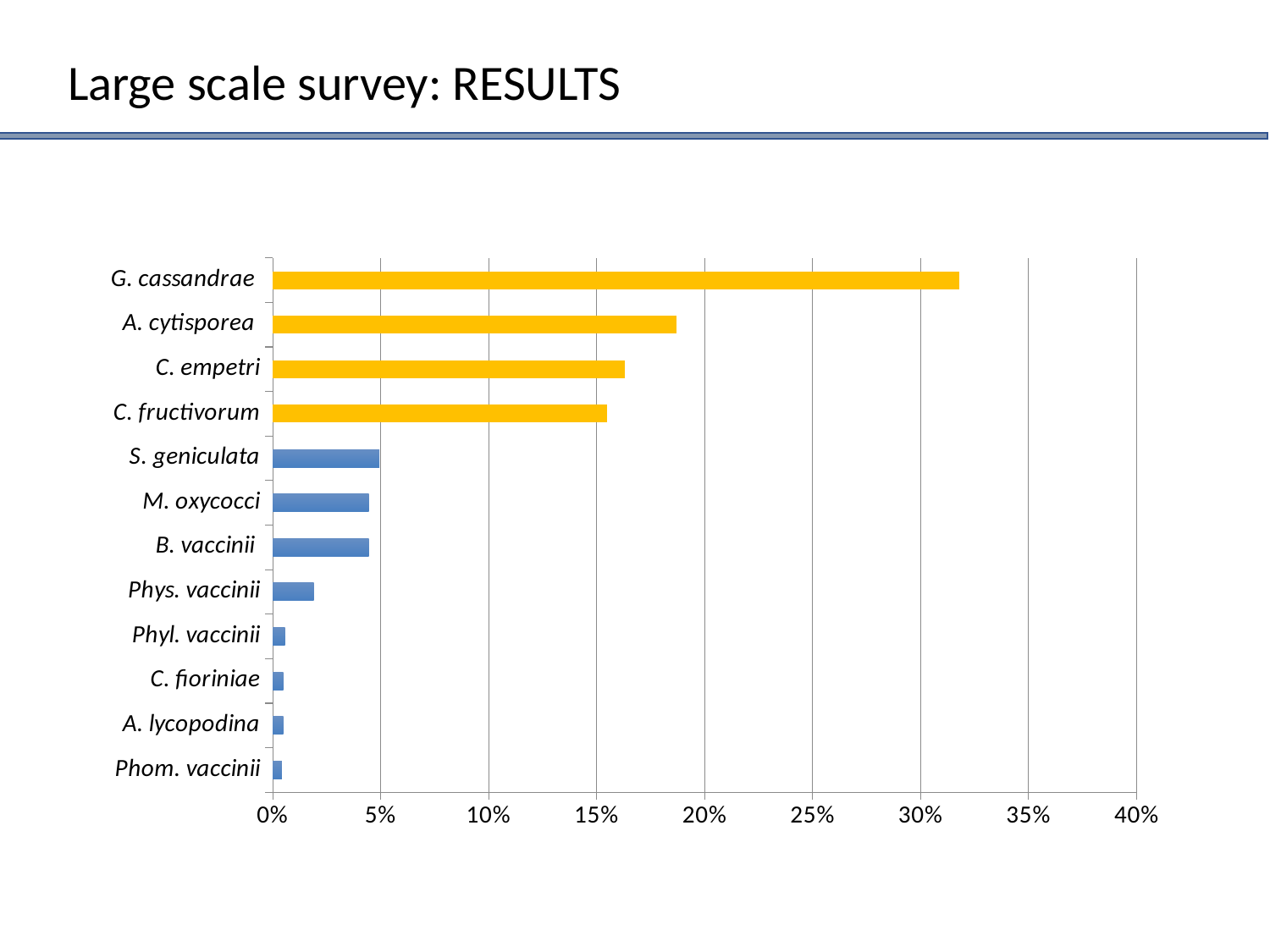
What kind of chart is shown on the slide? bar chart How many species (categories) are plotted in the chart? 12 Which is larger, the value for A. cytisporea or the value for C. empetri? A. cytisporea Is the value for G. cassandrae greater or less than 30%? greater Which species has the highest value in the chart? G. cassandrae How many bars in the chart are coloured yellow/orange rather than blue? 4 Is the value for A. cytisporea greater or less than 20%? less Which is larger, the value for S. geniculata or the value for Phys. vaccinii? S. geniculata Is the value for Phys. vaccinii greater or less than 5%? less